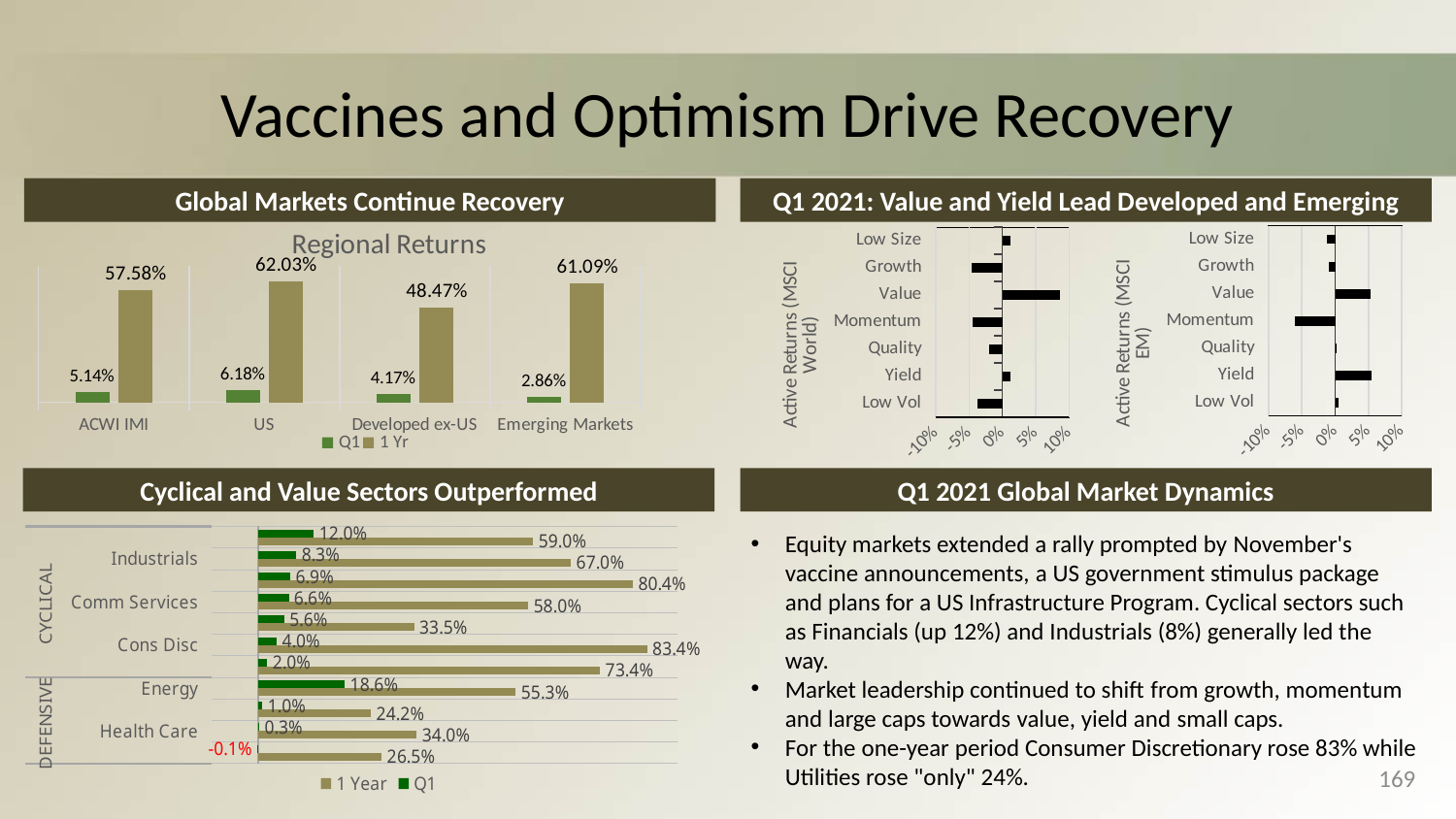
In the Regional Returns chart, what is the Q1 return for Emerging Markets? 2.86% In the Regional Returns chart, which region has the highest Q1 return? US In the Active Returns (MSCI World) chart, how many factor categories are shown? 7 In the Active Returns (MSCI EM) chart, is the value for Momentum greater or less than 0%? less In the Cyclical and Value Sectors Outperformed chart, what is the 1 Year return for Cons Disc? 83.4% In the Regional Returns chart, what is the difference between the 1 Yr returns of the US and ACWI IMI? 4.45% In the Regional Returns chart, which region has the lowest 1 Yr return? Developed ex-US In the Cyclical and Value Sectors Outperformed chart, which is larger: the 1 Year return for Industrials or for Health Care? Industrials In the Active Returns (MSCI World) chart, is the value for Value greater or less than 5%? greater In the Regional Returns chart, how many series does the legend list? 2 In the Regional Returns chart, what is the 1 Yr return for the US? 62.03% In the Cyclical and Value Sectors Outperformed chart, what is the Q1 return for Energy? 18.6%